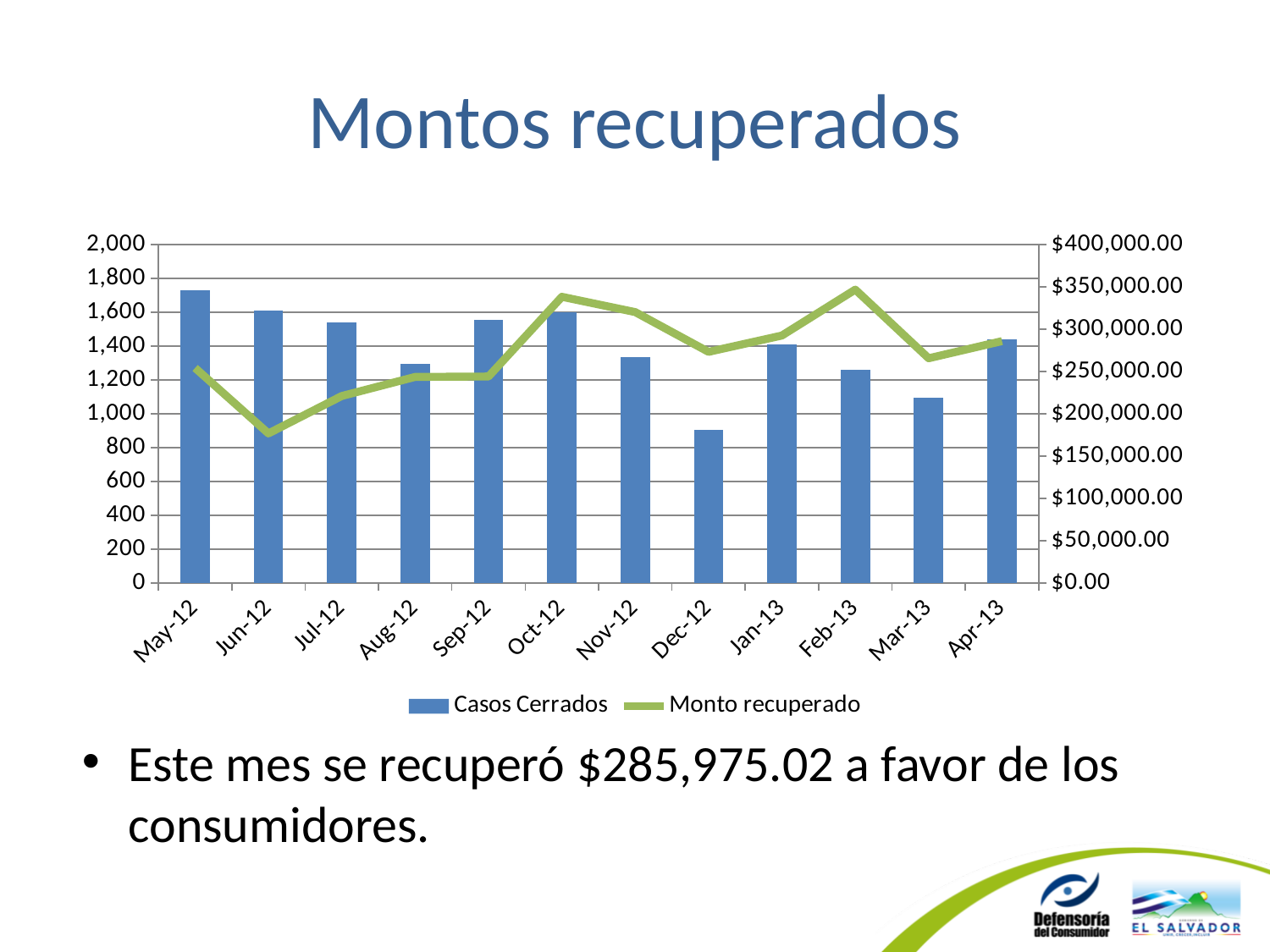
Is the Monto recuperado value for Feb-13 greater or less than $300,000.00? greater Which month has the lowest Casos Cerrados bar? Dec-12 Which month has the highest Casos Cerrados bar? May-12 Is the Casos Cerrados value for May-12 greater or less than 1,600? greater Is the Casos Cerrados value for Dec-12 greater or less than 1,000? less How many months are shown on the x axis? 12 Which month has the lowest Monto recuperado value? Jun-12 Which series is drawn as a line? Monto recuperado Does the Monto recuperado line rise or fall from Jun-12 to Oct-12? rise How many series does the legend list? 2 What kind of chart is this? Combined bar and line chart What is the title of the chart? Montos recuperados